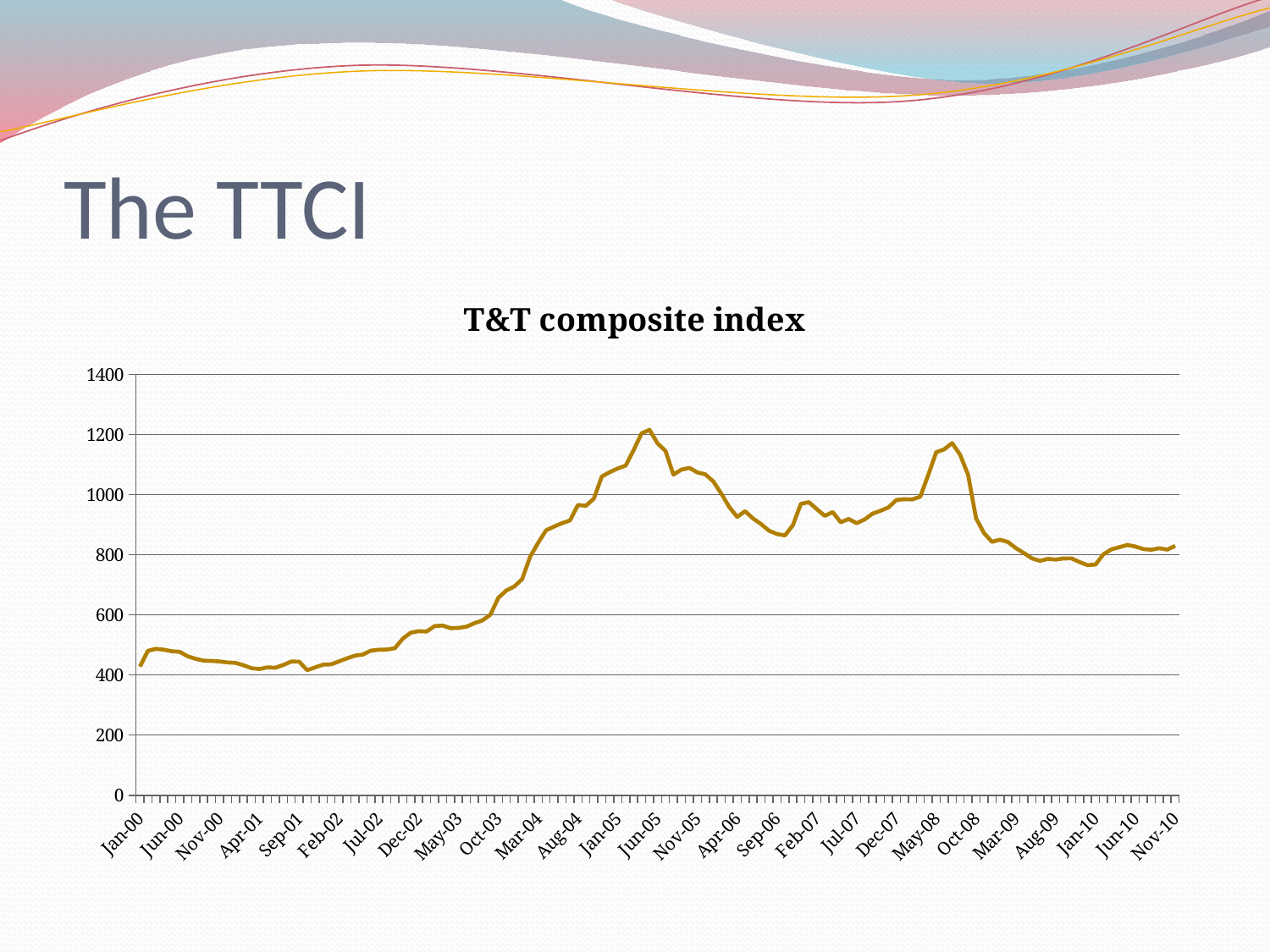
What is the title of the chart? T&T composite index How many date labels are shown along the x axis? 27 Is the value for Mar-09 greater or less than 1000? less Is the value for Jan-00 greater or less than 600? less Is the value for Oct-03 greater or less than 800? less What kind of chart is shown on the slide? line chart Which is higher, the peak of the index around Jun-05 or the peak around May-08? Jun-05 Does the index overall rise or fall between Jan-00 and Jun-05? rise What is the highest value shown on the y axis of the chart? 1400